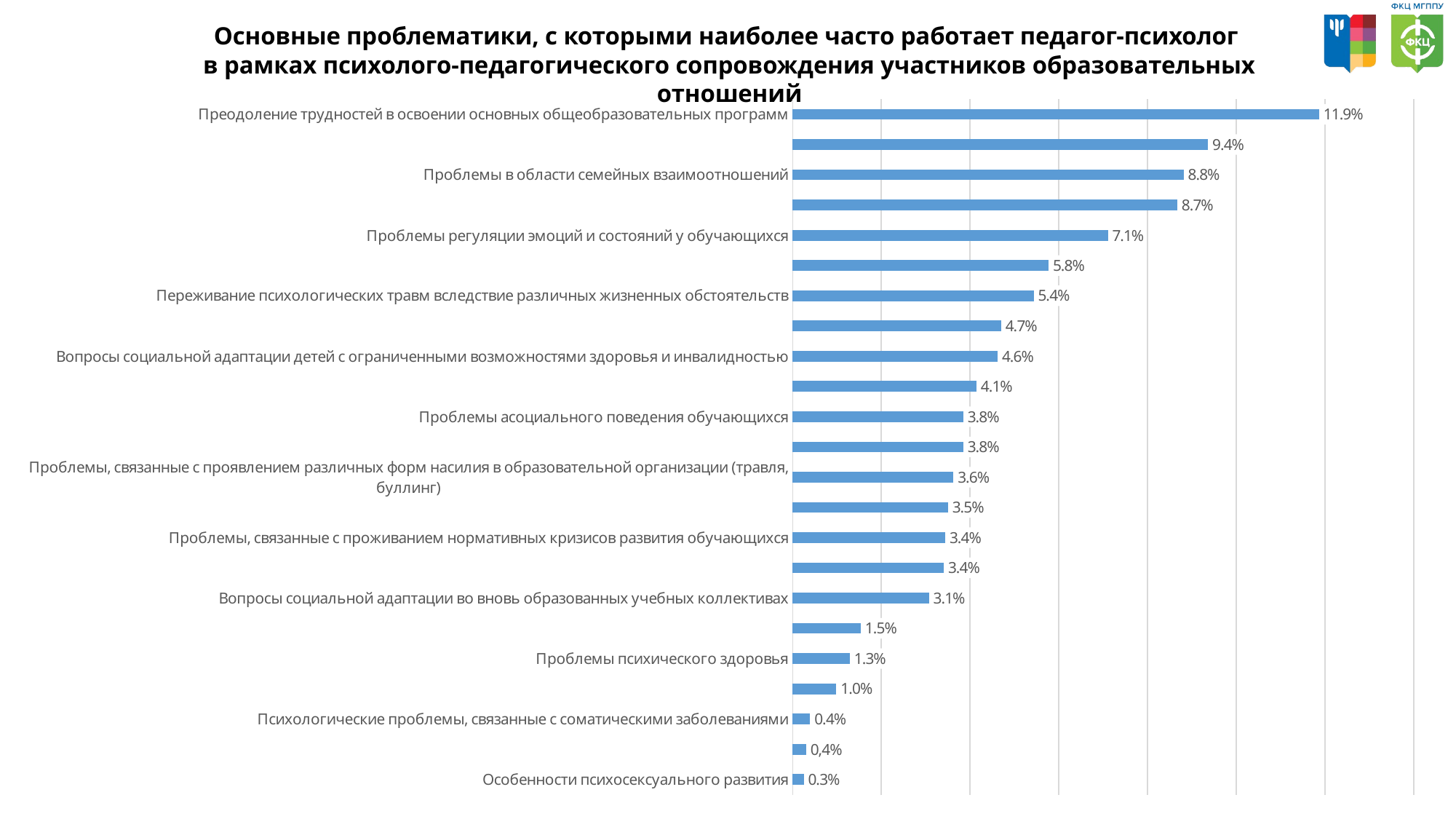
Which is larger: the value for "Переживание психологических травм вследствие различных жизненных обстоятельств" or for "Проблемы асоциального поведения обучающихся"? Переживание психологических травм вследствие различных жизненных обстоятельств What kind of chart is shown on the slide? Bar chart What is the difference between the values for "Преодоление трудностей в освоении основных общеобразовательных программ" and "Проблемы в области семейных взаимоотношений"? 3.1% How many bars are plotted in the chart? 23 Which category has the lowest value? Особенности психосексуального развития What is the value for "Вопросы социальной адаптации во вновь образованных учебных коллективах"? 3.1% What is the value for "Проблемы в области семейных взаимоотношений"? 8.8% Which category has the highest value? Преодоление трудностей в освоении основных общеобразовательных программ What is the value for "Преодоление трудностей в освоении основных общеобразовательных программ"? 11.9% What is the value for "Особенности психосексуального развития"? 0.3% What is the value for "Проблемы психического здоровья"? 1.3% What is the value for "Проблемы регуляции эмоций и состояний у обучающихся"? 7.1%